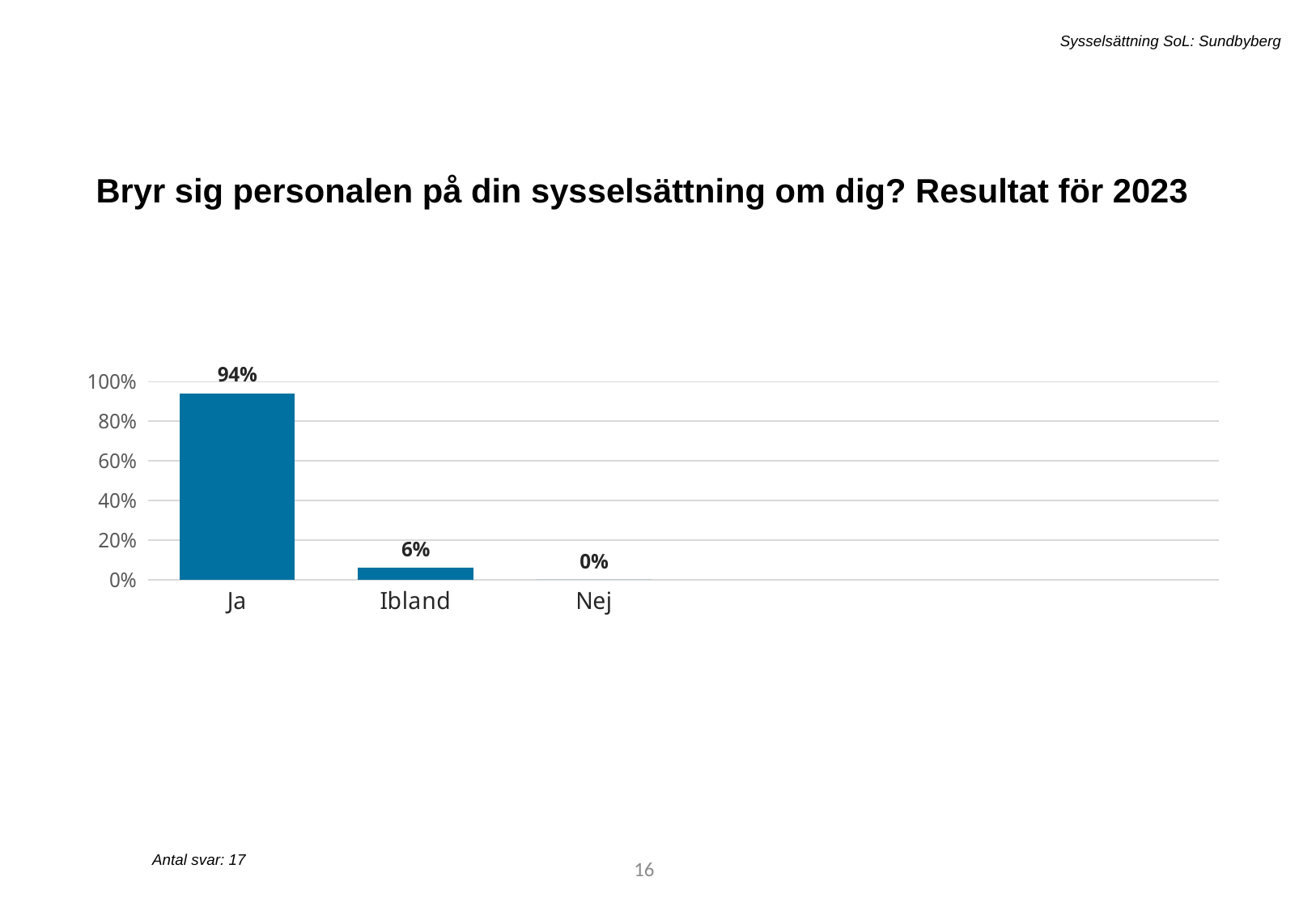
Do the values rise or fall from left to right along the x axis? fall What is the value for Ja? 94% What is the value for Nej? 0% Is the value for Ja greater or less than 80%? greater How many categories are shown on the x axis? 3 What is the difference between the values for Ja and Ibland? 88% What kind of chart is shown on the slide? bar chart Which category has the lowest value? Nej Which is larger, the value for Ibland or the value for Nej? Ibland What is the value for Ibland? 6% What is the title of the chart? Bryr sig personalen på din sysselsättning om dig? Resultat för 2023 Which category has the highest value? Ja